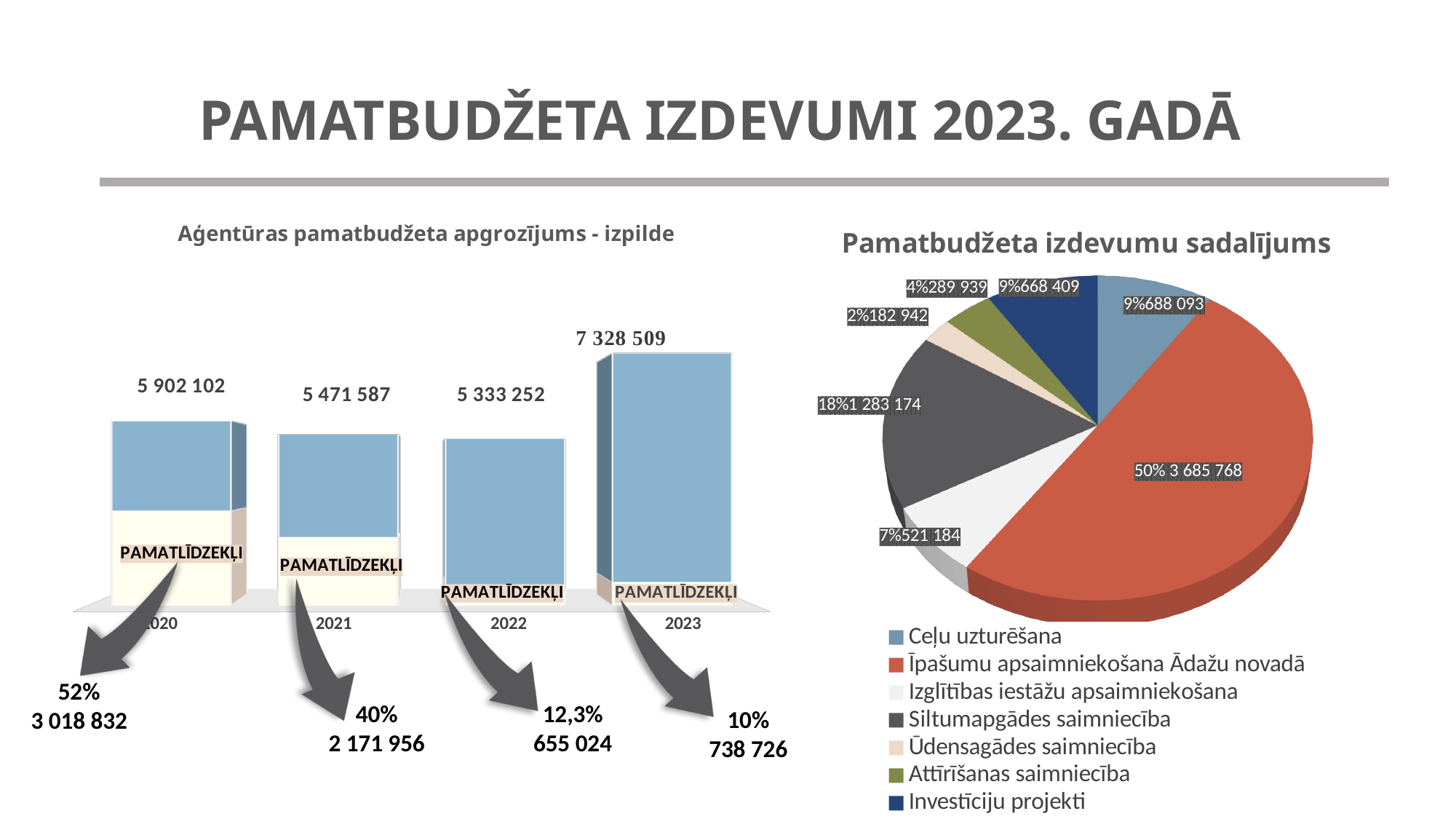
In the bar chart 'Aģentūras pamatbudžeta apgrozījums - izpilde', what is the value for 2020? 5 902 102 In the pie chart 'Pamatbudžeta izdevumu sadalījums', which category has the smallest slice? Ūdensagādes saimniecība In the bar chart 'Aģentūras pamatbudžeta apgrozījums - izpilde', what is the difference between the 2023 value and the 2022 value? 1 995 257 In the pie chart 'Pamatbudžeta izdevumu sadalījums', what is the value for 'Siltumapgādes saimniecība'? 1 283 174 In the bar chart 'Aģentūras pamatbudžeta apgrozījums - izpilde', which year has the lowest value? 2022 In the pie chart 'Pamatbudžeta izdevumu sadalījums', what share does 'Īpašumu apsaimniekošana Ādažu novadā' have? 50% In the bar chart 'Aģentūras pamatbudžeta apgrozījums - izpilde', what is the value for 2023? 7 328 509 What kind of chart is 'Pamatbudžeta izdevumu sadalījums'? Pie chart How many entries does the legend of the pie chart 'Pamatbudžeta izdevumu sadalījums' list? 7 In the bar chart 'Aģentūras pamatbudžeta apgrozījums - izpilde', what share and amount of PAMATLĪDZEKĻI is shown for 2021? 40%, 2 171 956 In the bar chart 'Aģentūras pamatbudžeta apgrozījums - izpilde', which year has the highest value? 2023 In the bar chart 'Aģentūras pamatbudžeta apgrozījums - izpilde', how many years are shown? 4